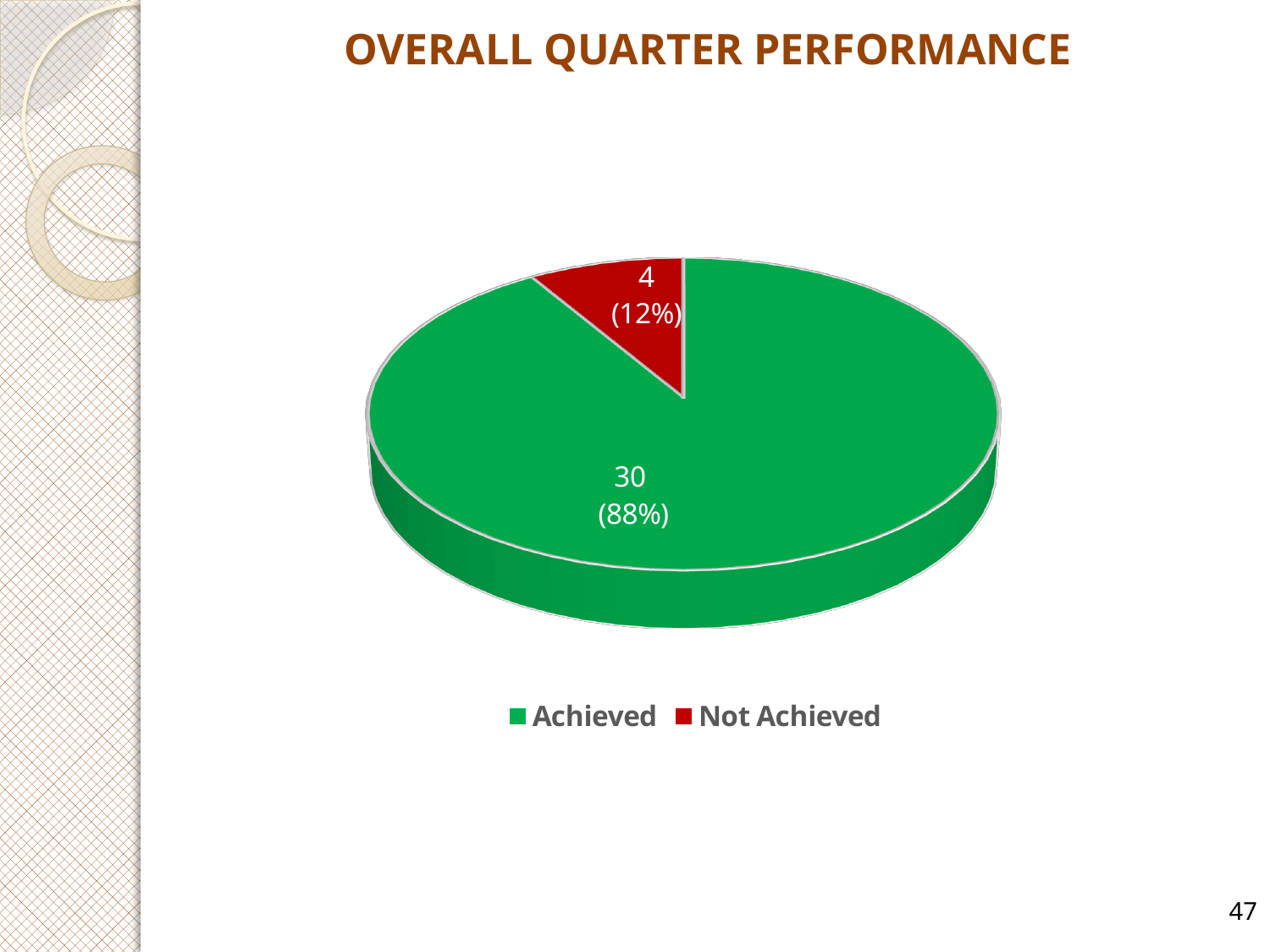
What is the difference between the Achieved and Not Achieved values? 26 What is the value for Achieved? 30 How many categories does the pie chart have? 2 Which category has the largest slice? Achieved What share of the pie does Not Achieved represent? 12% What kind of chart is shown on the slide? pie chart What is the value for Not Achieved? 4 Which is larger, Achieved or Not Achieved? Achieved Which category has the smallest slice? Not Achieved What colour is the Not Achieved slice? red What share of the pie does Achieved represent? 88% What is the title of the chart? OVERALL QUARTER PERFORMANCE